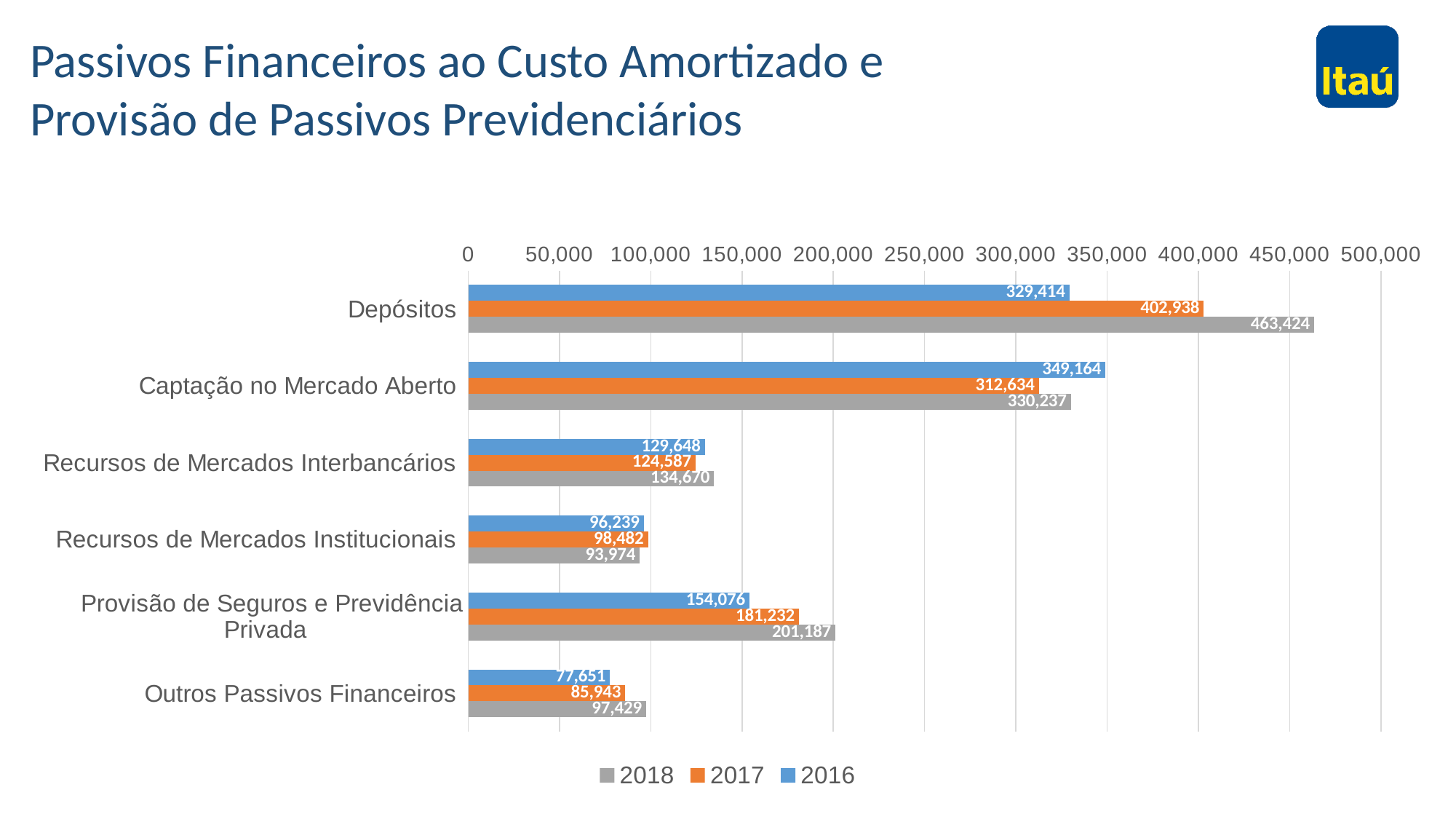
What is the 2017 value for Provisão de Seguros e Previdência Privada? 181,232 What type of chart is shown on the slide? bar chart What is the 2016 value for Captação no Mercado Aberto? 349,164 Which category has the lowest 2016 value? Outros Passivos Financeiros Is the 2018 value for Provisão de Seguros e Previdência Privada greater or less than 200,000? greater How many categories are shown on the chart? 6 How many series does the legend list? 3 Which colour represents the 2017 series in the legend? orange Which category has the highest 2018 value? Depósitos What is the difference between the 2018 and 2017 values for Depósitos? 60,486 Which is larger for Captação no Mercado Aberto, the 2016 value or the 2017 value? 2016 What is the 2018 value for Depósitos? 463,424